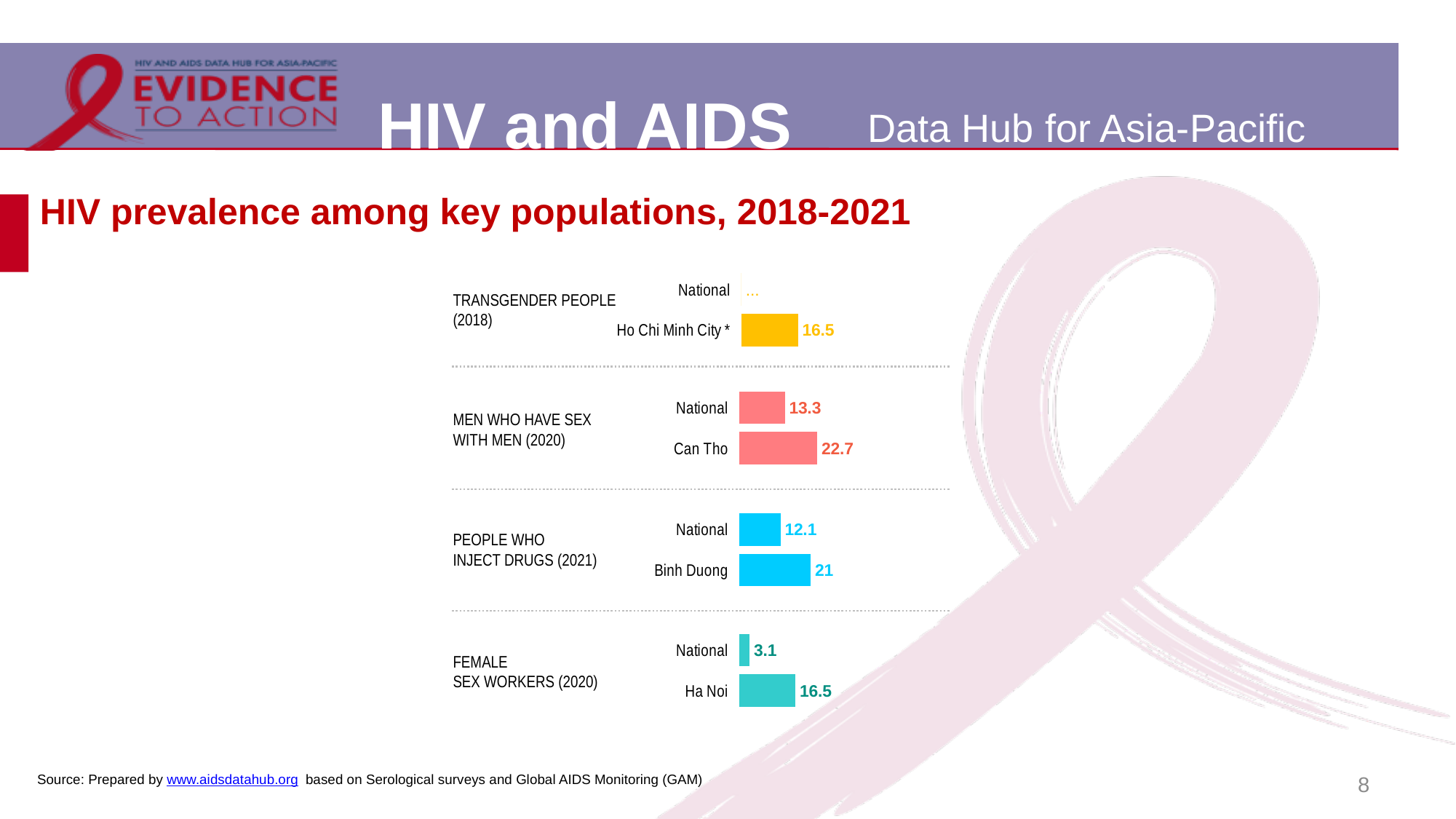
Which bar shows the lowest HIV prevalence value on the chart? National (female sex workers) What kind of chart is shown on the slide? Bar chart Which bar shows the highest HIV prevalence value on the chart? Can Tho (men who have sex with men) What is the difference between the HIV prevalence among people who inject drugs in Binh Duong and the national value? 8.9 What is the HIV prevalence among men who have sex with men in Can Tho (2020)? 22.7 How many key population groups are shown on the chart? 4 What is the national HIV prevalence among female sex workers (2020)? 3.1 What is the national HIV prevalence among people who inject drugs (2021)? 12.1 What is the HIV prevalence among transgender people in Ho Chi Minh City (2018)? 16.5 Which is larger: the national HIV prevalence among men who have sex with men or the national HIV prevalence among people who inject drugs? Men who have sex with men What is the difference between the HIV prevalence among men who have sex with men in Can Tho and the national value? 9.4 What is the HIV prevalence among female sex workers in Ha Noi (2020)? 16.5